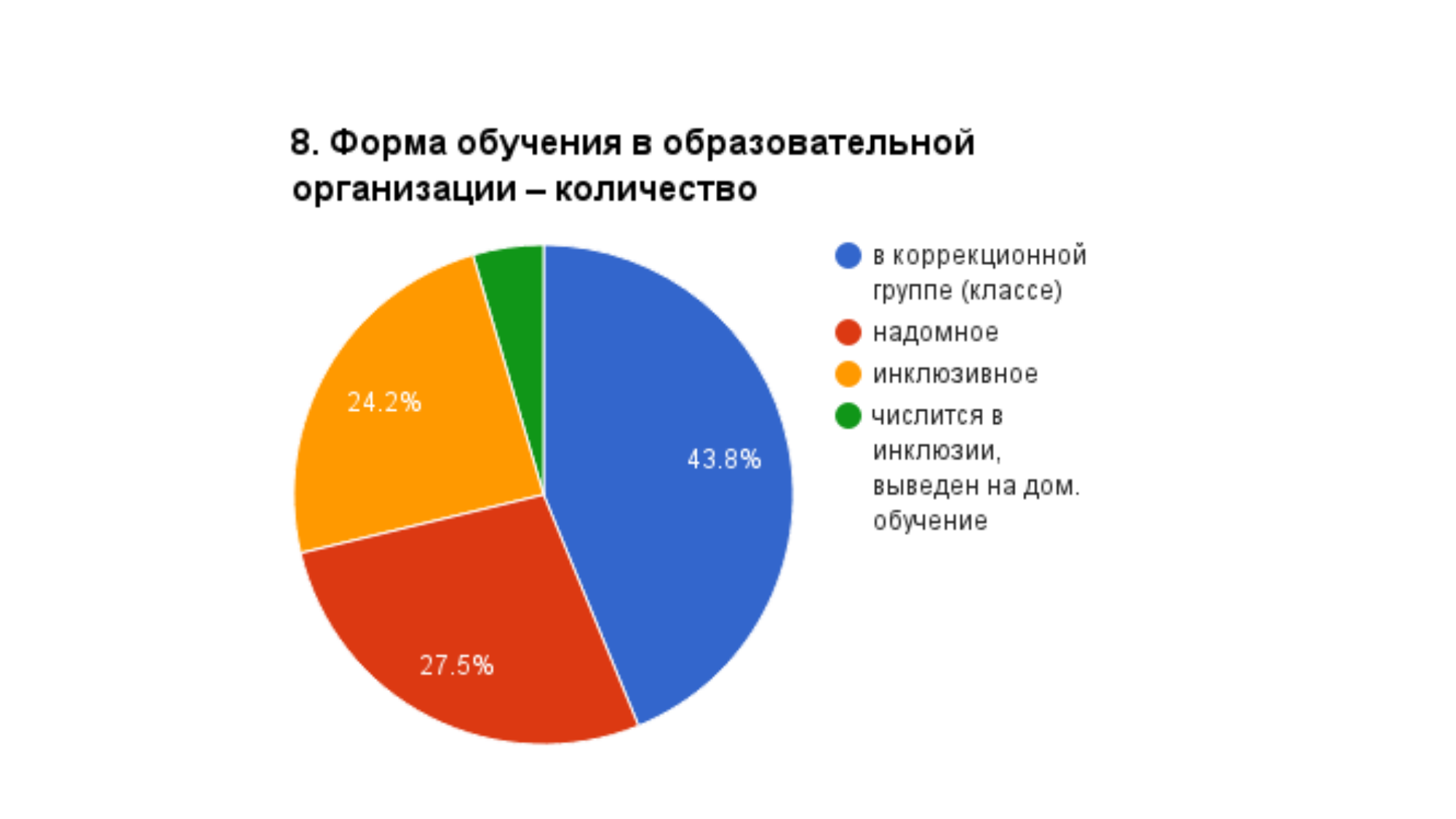
What percentage is shown for the slice 'надомное'? 27.5% What kind of chart is shown on the slide? Pie chart What percentage is shown for the slice 'в коррекционной группе (классе)'? 43.8% What is the difference in percentage points between 'в коррекционной группе (классе)' and 'надомное'? 16.3 percentage points How many slices does the pie chart have? 4 Which category has the smallest slice of the pie? числится в инклюзии, выведен на дом. обучение What is the title of the chart? 8. Форма обучения в образовательной организации – количество Which slice is larger, 'надомное' or 'инклюзивное'? надомное What is the difference in percentage points between 'надомное' and 'инклюзивное'? 3.3 percentage points What colour is the slice for 'инклюзивное'? Orange Which category has the largest slice of the pie? в коррекционной группе (классе) What share of the pie does 'инклюзивное' take? 24.2%